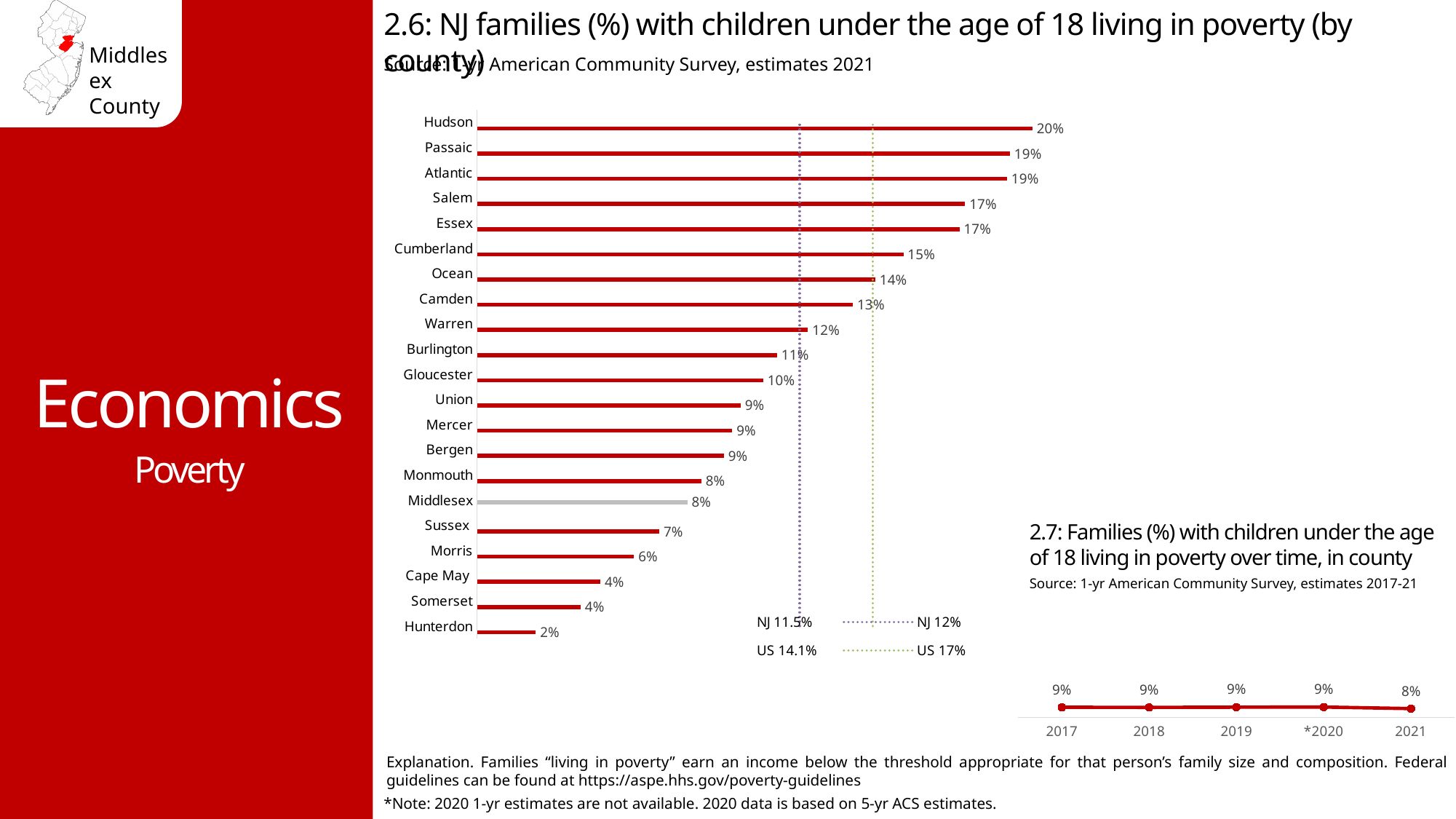
In chart 2.6, what is the value for Essex? 17% In chart 2.7, do the values rise or fall from 2017 to 2021? Fall In chart 2.6, which county has a larger value, Cumberland or Camden? Cumberland How many counties are shown in chart 2.6? 21 In chart 2.6, which county has the highest percentage of families with children living in poverty? Hudson In chart 2.7, how many years are plotted? 5 In chart 2.6, which county has the lowest percentage of families with children living in poverty? Hunterdon What kind of chart is chart 2.6? Bar chart In chart 2.7 (families with children under 18 living in poverty over time, in county), what is the value for 2021? 8% In chart 2.6 (NJ families with children under 18 living in poverty by county), what is the value for Middlesex? 8% In chart 2.6, what is the difference between the values for Hudson and Hunterdon? 18%